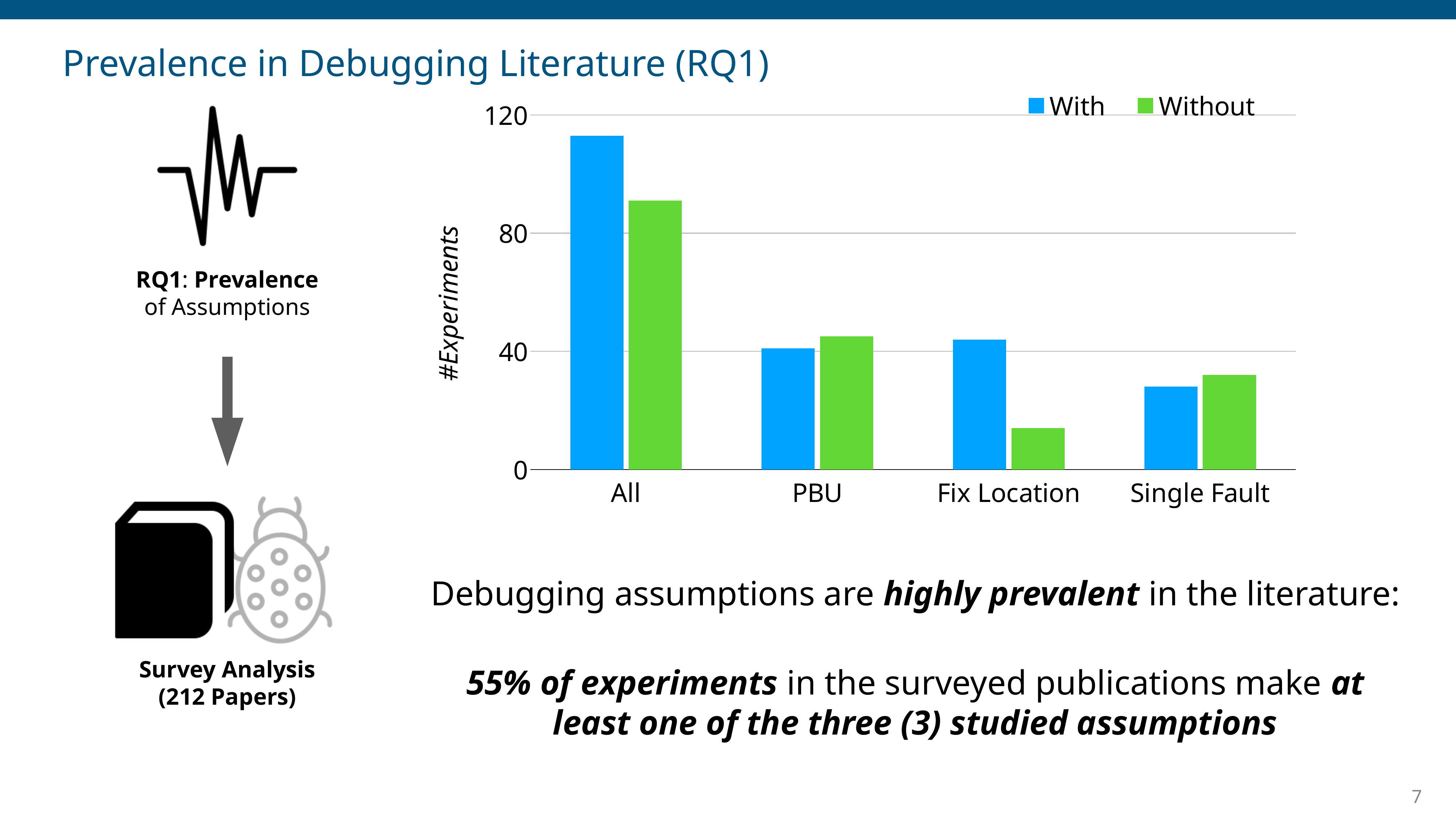
Which category has the lowest 'Without' bar? Fix Location What is the label on the y axis of the chart? #Experiments Is the 'With' value for All greater or less than 80? greater Which series is shown in green in the chart? Without For Fix Location, which is larger: the 'With' bar or the 'Without' bar? With Is the 'Without' value for Fix Location greater or less than 40? less Which category has the highest 'With' bar? All How many series does the chart's legend list? 2 How many categories are shown on the x axis of the chart? 4 What kind of chart is shown on the slide? bar chart For Single Fault, which is larger: the 'With' bar or the 'Without' bar? Without Is the 'With' value for Single Fault greater or less than 40? less